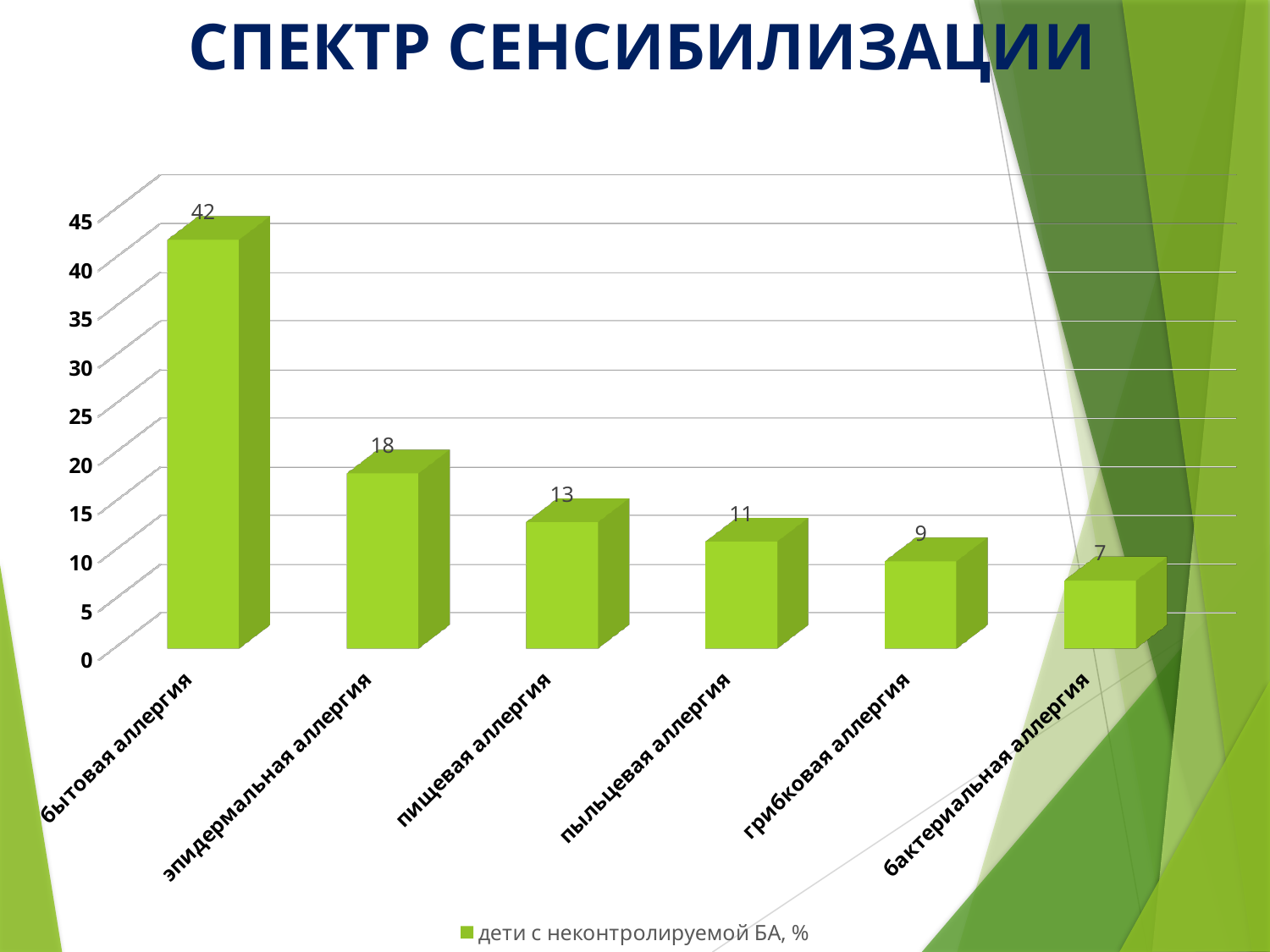
How many categories are shown on the chart? 6 What is the value for бытовая аллергия? 42 What is the value for бактериальная аллергия? 7 What kind of chart is shown on the slide? bar chart What is the value for пищевая аллергия? 13 Which category has the highest value? бытовая аллергия Which category has the lowest value? бактериальная аллергия What is the difference between the values for бытовая аллергия and эпидермальная аллергия? 24 Is the value for эпидермальная аллергия greater or less than 15? greater How many series does the legend list? 1 Which is larger, the value for пыльцевая аллергия or грибковая аллергия? пыльцевая аллергия What is the legend entry of the chart? дети с неконтролируемой БА, %